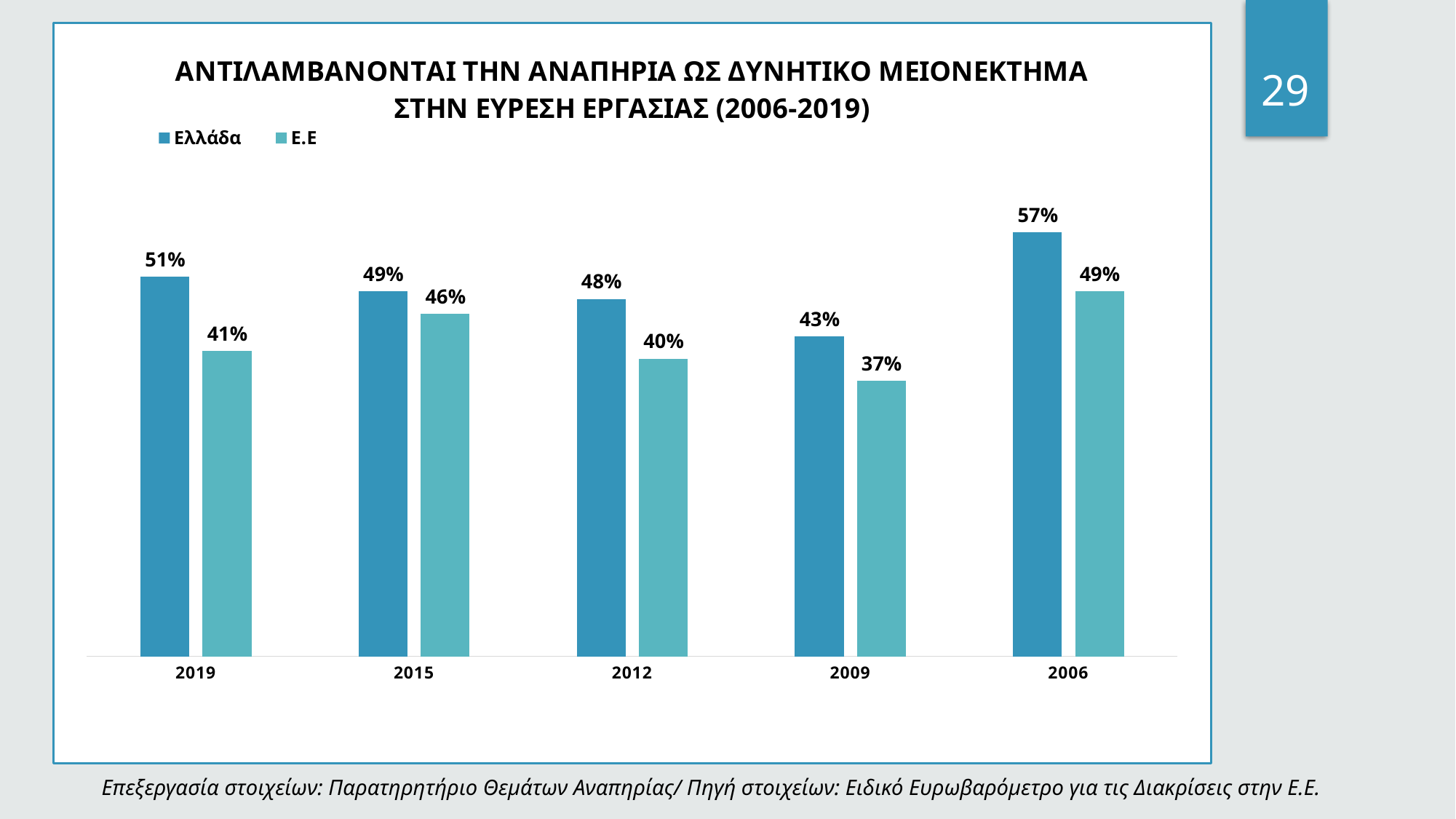
In which year is the Ελλάδα value highest? 2006 What is the difference between the Ελλάδα values in 2006 and 2009? 14% How many years are shown on the x axis? 5 What is the difference between the Ελλάδα and Ε.Ε values in 2019? 10% What is the value for Ε.Ε in 2006? 49% In which year is the Ε.Ε value lowest? 2009 What are the two series named in the legend? Ελλάδα and Ε.Ε What is the value for Ε.Ε in 2009? 37% What is the value for Ελλάδα in 2019? 51% How many series does the legend list? 2 What kind of chart is shown on the slide? Bar chart Which is larger in 2012, the Ελλάδα value or the Ε.Ε value? Ελλάδα